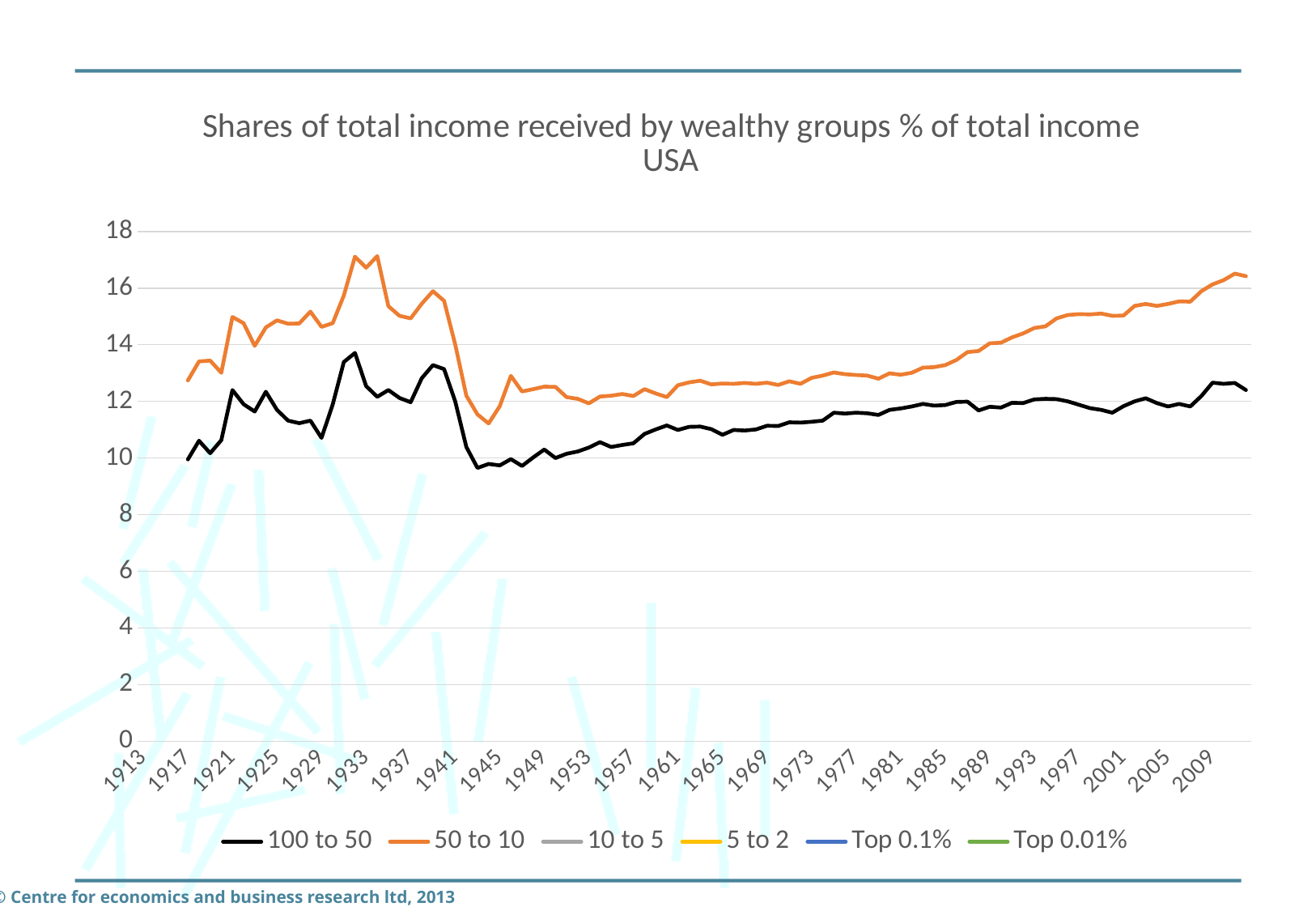
Is the value for "50 to 10" in 1933 greater or less than 16? greater How many series does the legend list? 6 Is the value for "100 to 50" in 1945 greater or less than 10? less What is the title of the chart? Shares of total income received by wealthy groups % of total income USA Does the "50 to 10" series rise or fall between 1981 and 2009? rise What kind of chart is shown on the slide? line chart Is the value for "100 to 50" in 1933 greater or less than 12? greater In 1933, which series has the higher value, "50 to 10" or "100 to 50"? 50 to 10 What colour is the line for the "50 to 10" series? orange Does the "100 to 50" series rise or fall between 1941 and 1945? fall